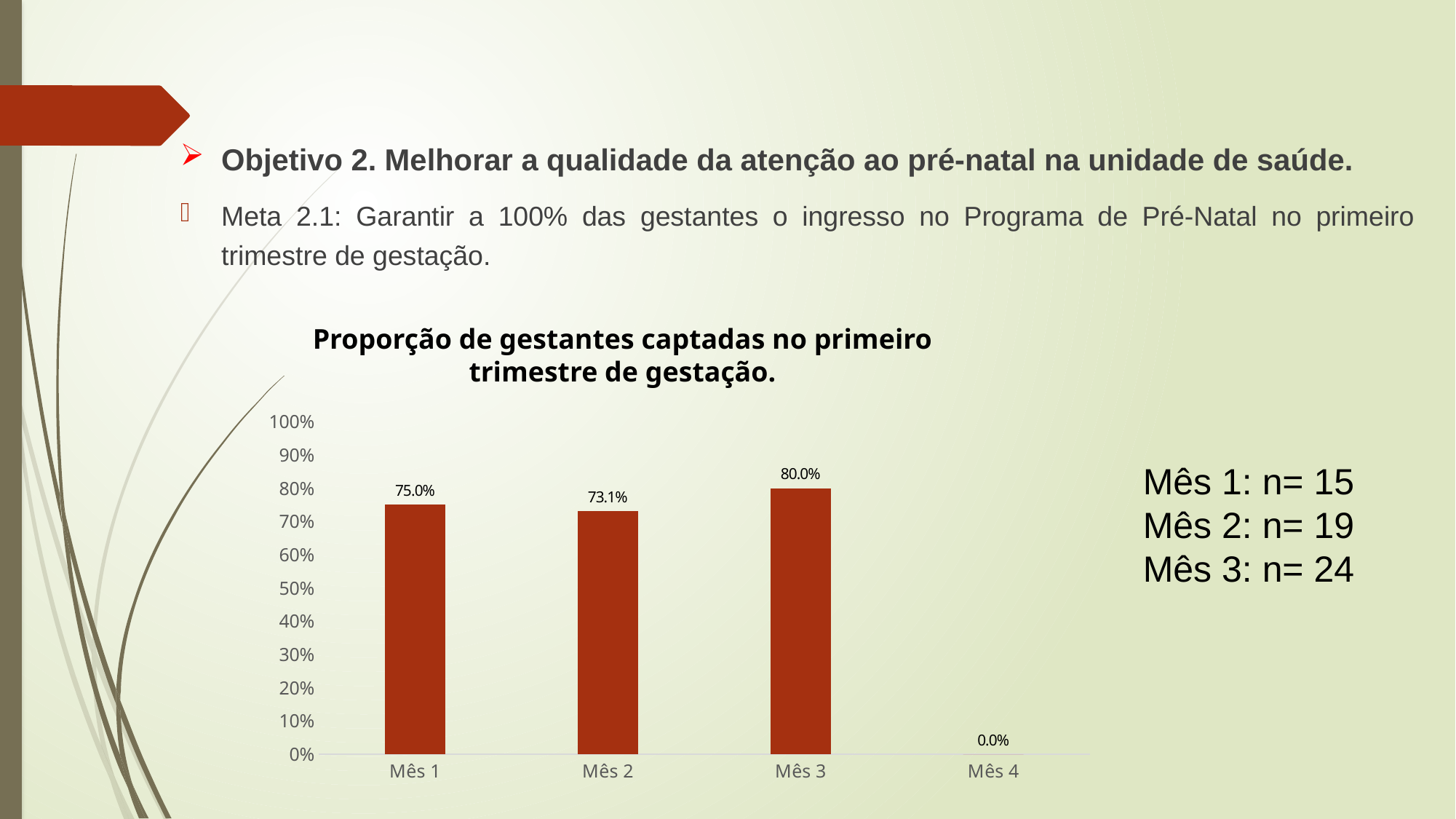
How many months are shown on the x axis? 4 What kind of chart is shown on the slide? bar chart What is the value for Mês 2? 73.1% What is the value for Mês 3? 80.0% What is the value for Mês 1? 75.0% Which month has the highest value? Mês 3 Is the value for Mês 3 greater or less than 70%? greater Which is larger, the value for Mês 1 or Mês 2? Mês 1 What is the title of the chart? Proporção de gestantes captadas no primeiro trimestre de gestação. Which month has the lowest value? Mês 4 What is the difference between the values for Mês 3 and Mês 1? 5.0% What is the value for Mês 4? 0.0%